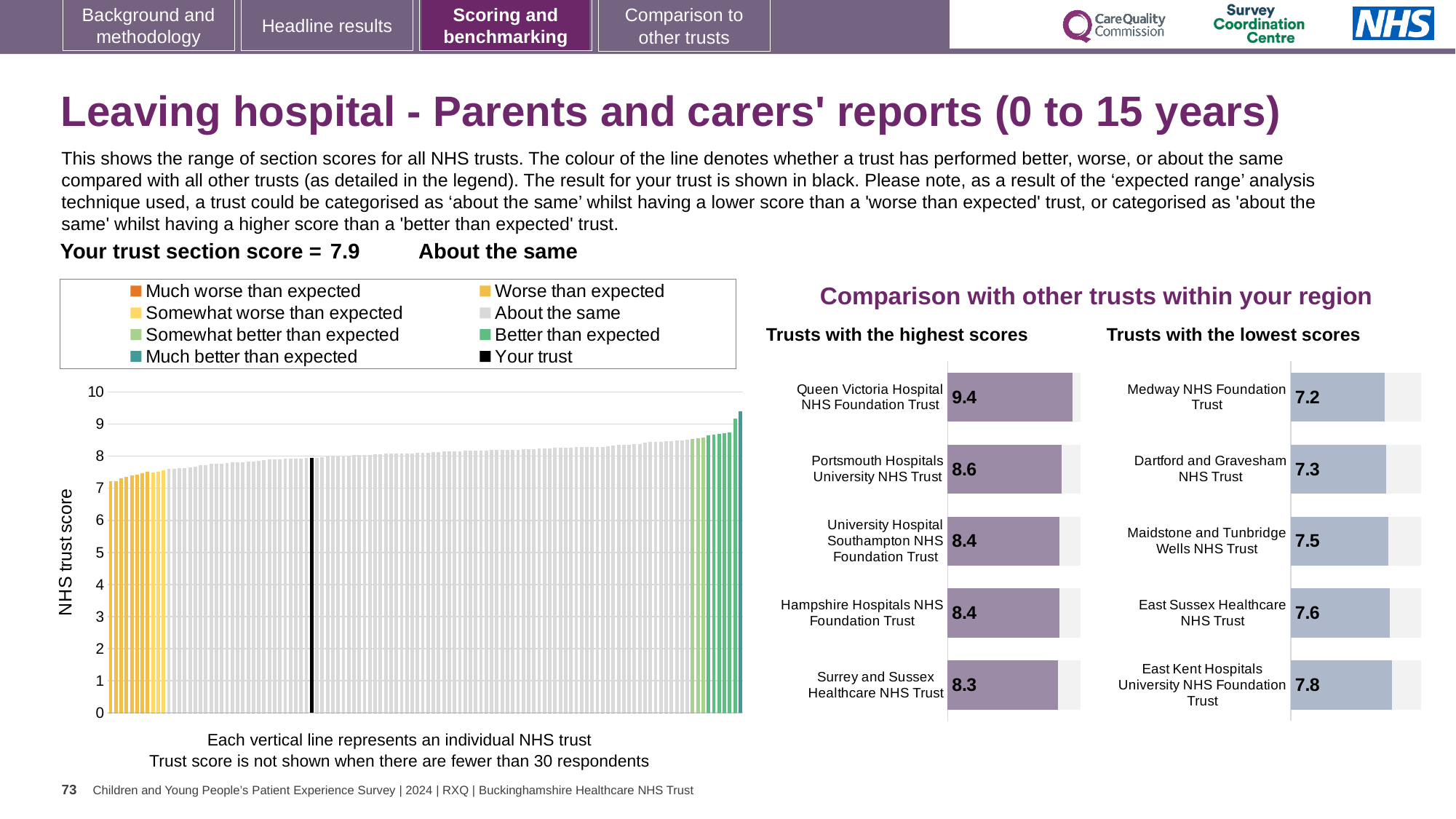
How many trusts are listed in the 'Trusts with the lowest scores' chart? 5 In the 'Trusts with the highest scores' chart, what is the difference between the scores of Queen Victoria Hospital NHS Foundation Trust and Surrey and Sussex Healthcare NHS Trust? 1.1 In the 'Trusts with the lowest scores' chart, what is the difference between the scores of East Kent Hospitals University NHS Foundation Trust and Medway NHS Foundation Trust? 0.6 How many entries does the legend of the large chart on the left list? 8 In the 'Trusts with the lowest scores' chart, what is the score for Medway NHS Foundation Trust? 7.2 In the large chart on the left, what is the section score for your trust (the black line)? 7.9 Which is larger: the score for Portsmouth Hospitals University NHS Trust in the highest scores chart or the score for Dartford and Gravesham NHS Trust in the lowest scores chart? Portsmouth Hospitals University NHS Trust In the large chart on the left, do the trust scores rise or fall from left to right? rise In the 'Trusts with the highest scores' chart, what is the score for Queen Victoria Hospital NHS Foundation Trust? 9.4 In the 'Trusts with the highest scores' chart, which trust has the lowest score shown? Surrey and Sussex Healthcare NHS Trust What type of chart is the 'Trusts with the highest scores' chart? bar chart In the 'Trusts with the lowest scores' chart, which trust has the highest score shown? East Kent Hospitals University NHS Foundation Trust